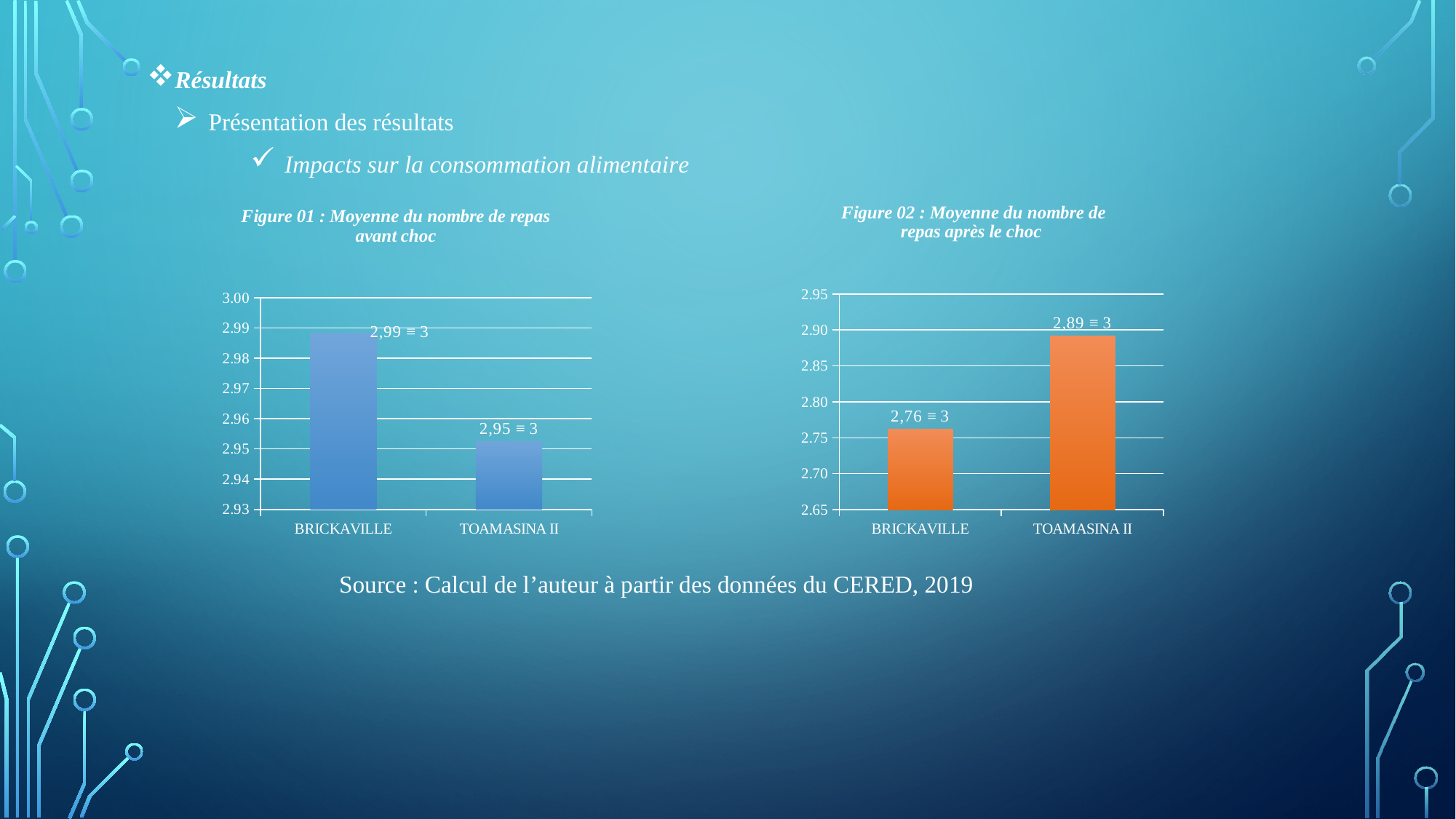
In Figure 02, what is the difference between the values for TOAMASINA II and BRICKAVILLE? 0,13 In Figure 01 (Moyenne du nombre de repas avant choc), what is the value for BRICKAVILLE? 2,99 In Figure 01, what is the difference between the values for BRICKAVILLE and TOAMASINA II? 0,04 How many categories are shown in Figure 01? 2 What kind of chart is Figure 02? bar chart In Figure 02, which category has the lowest value? BRICKAVILLE In Figure 02, is the value for BRICKAVILLE greater or less than 2.80? less In Figure 01, which category has the highest value? BRICKAVILLE In Figure 02 (Moyenne du nombre de repas après le choc), what is the value for BRICKAVILLE? 2,76 In Figure 01 (Moyenne du nombre de repas avant choc), what is the value for TOAMASINA II? 2,95 In Figure 02, which is larger: the value for BRICKAVILLE or the value for TOAMASINA II? TOAMASINA II In Figure 02 (Moyenne du nombre de repas après le choc), what is the value for TOAMASINA II? 2,89